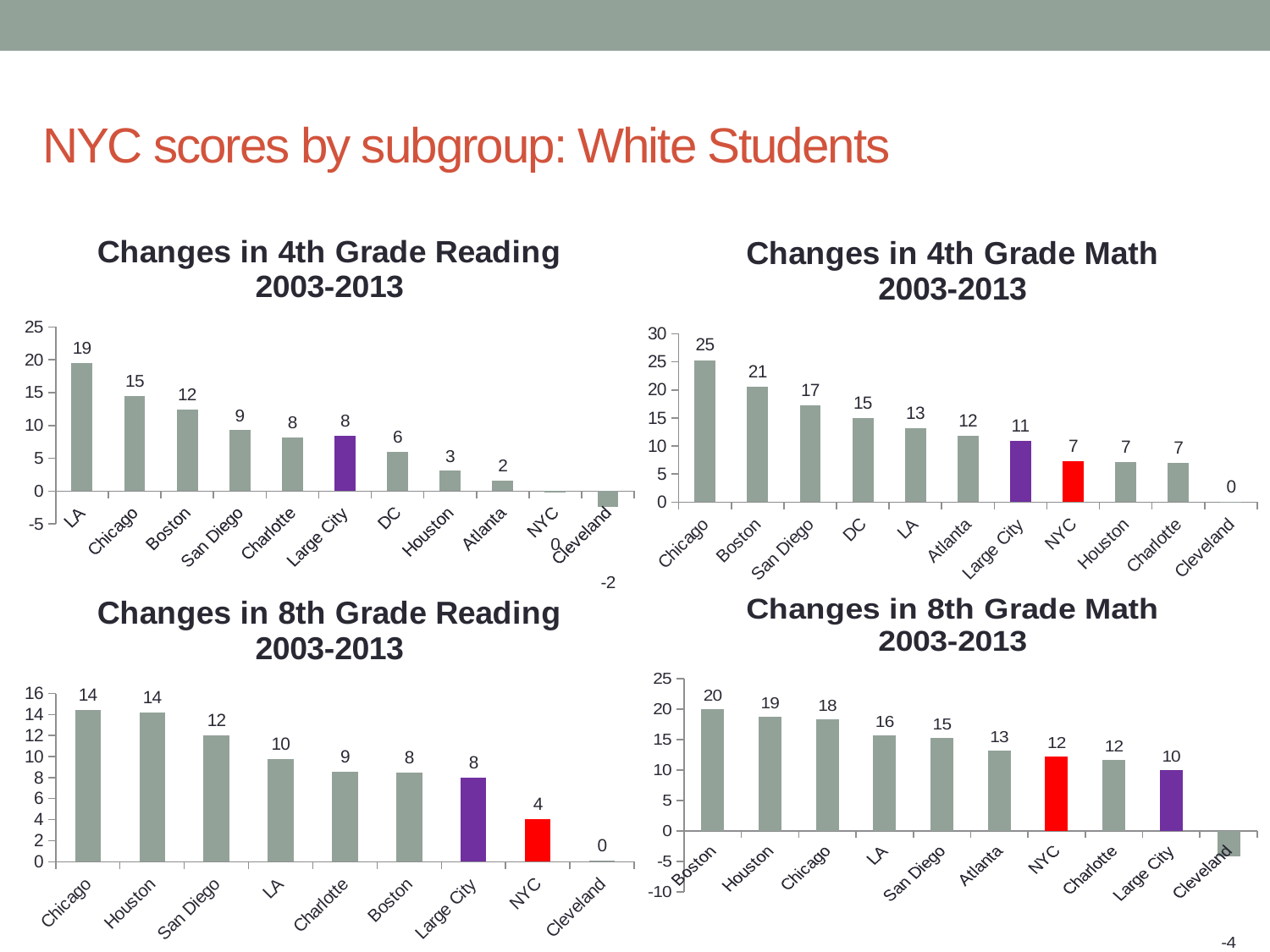
In the 'Changes in 4th Grade Reading 2003-2013' chart, what is the value for LA? 19 In the 'Changes in 4th Grade Math 2003-2013' chart, what is the difference between Chicago and Boston? 4 In the 'Changes in 8th Grade Math 2003-2013' chart, what is the value for Boston? 20 In the 'Changes in 8th Grade Reading 2003-2013' chart, what is the value for NYC? 4 In the 'Changes in 8th Grade Reading 2003-2013' chart, how many categories are shown? 9 What kind of chart is 'Changes in 8th Grade Math 2003-2013'? Bar chart In the 'Changes in 4th Grade Math 2003-2013' chart, what is the value for NYC? 7 In the 'Changes in 8th Grade Reading 2003-2013' chart, which is larger, San Diego or LA? San Diego In the 'Changes in 4th Grade Reading 2003-2013' chart, which city has the lowest value? Cleveland In the 'Changes in 8th Grade Math 2003-2013' chart, what is the difference between Houston and Large City? 9 In the 'Changes in 4th Grade Math 2003-2013' chart, which city has the highest value? Chicago In the 'Changes in 4th Grade Reading 2003-2013' chart, how many categories are shown? 11